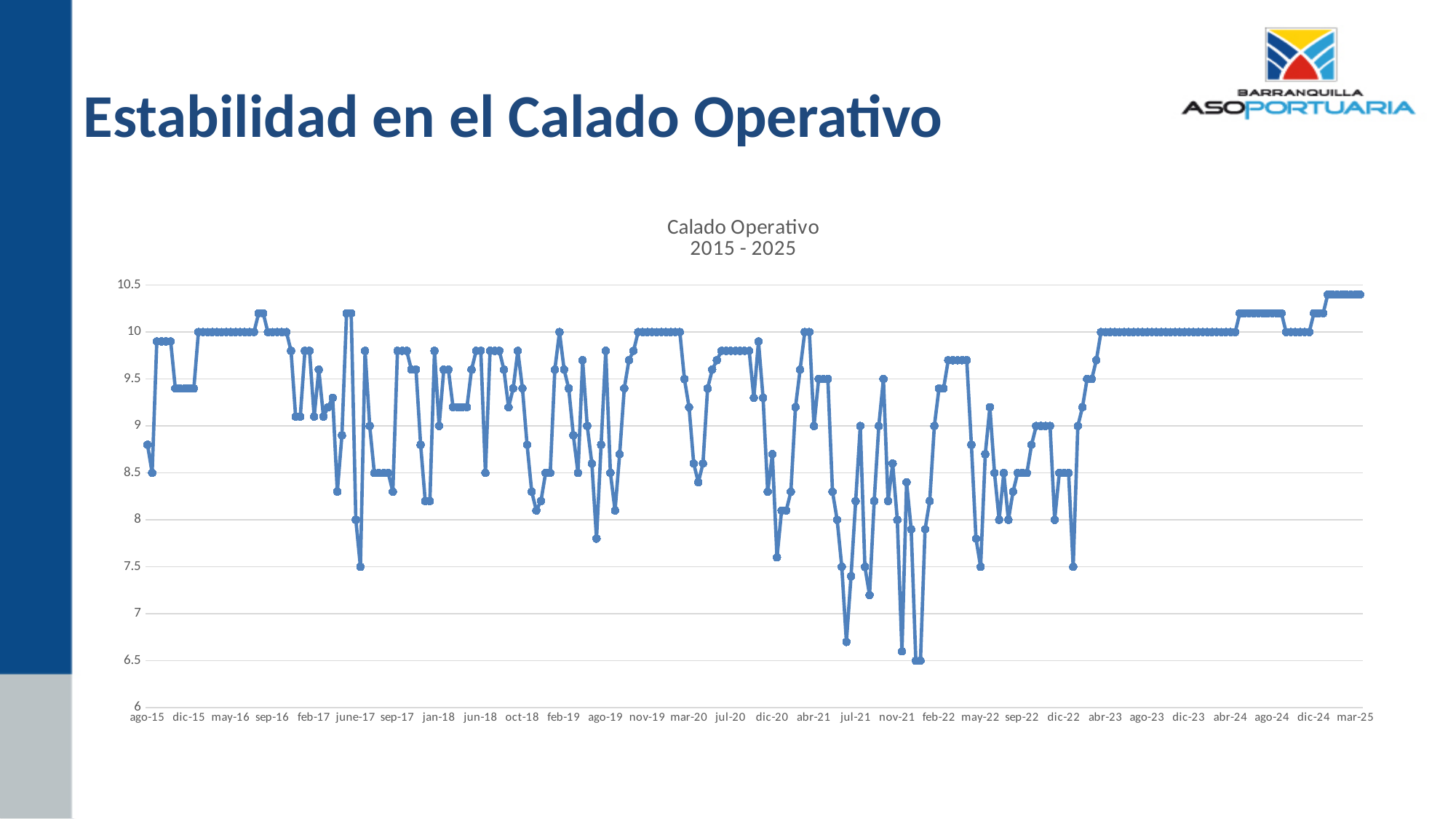
Is the value at dic-15 greater or less than 9? greater What kind of chart is shown on the slide? line chart Is the value at ago-23 greater or less than 9.5? greater What is the highest value shown on the y axis? 10.5 Is the value at dic-22 greater or less than 9? less What is the lowest value the line reaches, between nov-21 and feb-22? 6.5 From dic-22 to mar-25, do the values generally rise or fall? rise What is the title of the chart? Calado Operativo 2015 - 2025